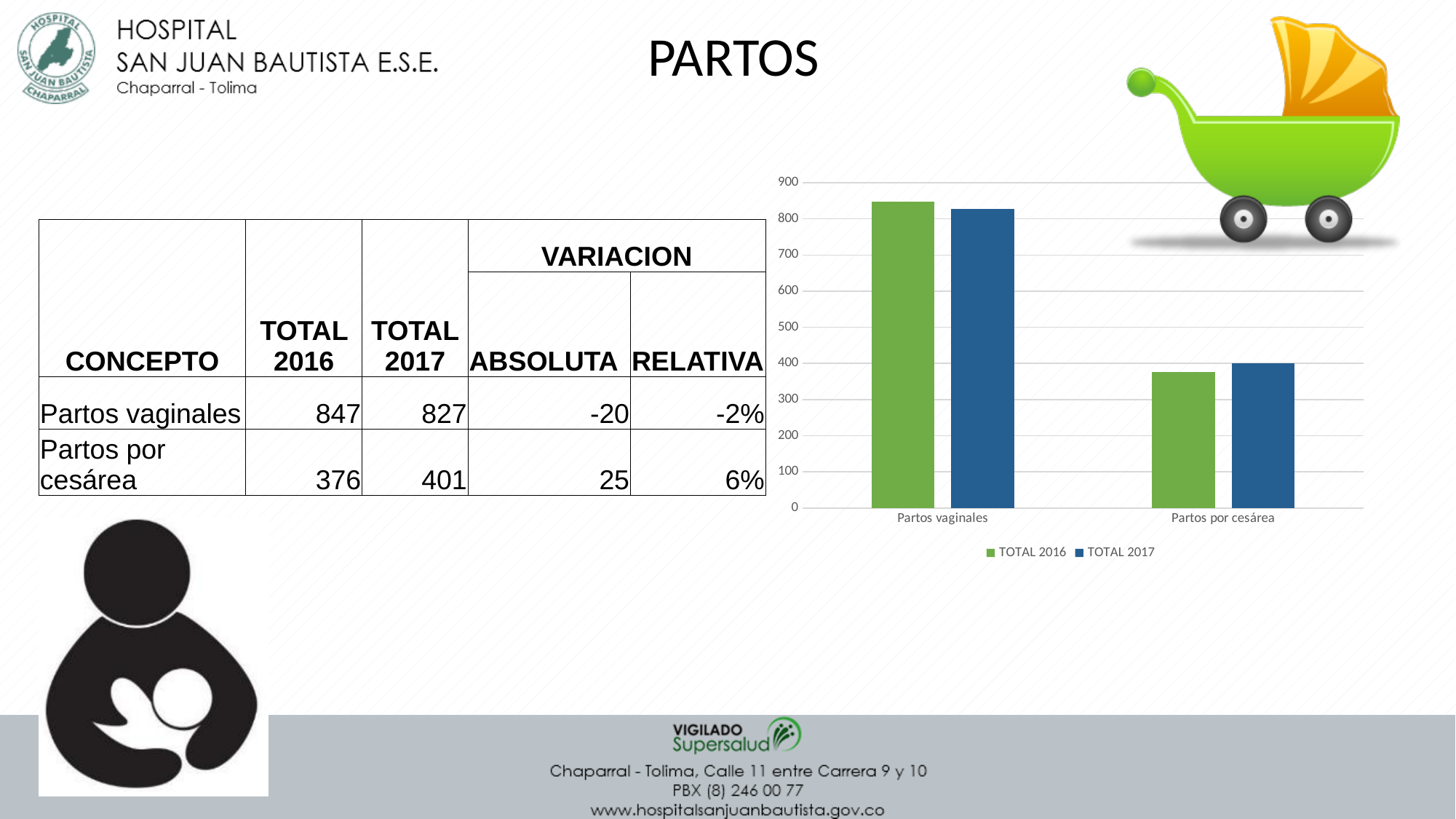
What is the TOTAL 2017 value for Partos vaginales, as printed in the table on the slide? 827 Is the TOTAL 2016 value for Partos por cesárea greater or less than 400? less For Partos vaginales, which is larger: TOTAL 2016 or TOTAL 2017? TOTAL 2016 Which category has the highest bar in the chart? Partos vaginales Which category has the lowest TOTAL 2016 value in the chart? Partos por cesárea Is the TOTAL 2017 value for Partos por cesárea greater or less than 500? less What kind of chart is shown on the slide? bar chart Which series does the green bar represent in the chart? TOTAL 2016 Is the TOTAL 2016 value for Partos vaginales greater or less than 800? greater How many series does the chart legend list? 2 What is the difference between the TOTAL 2017 and TOTAL 2016 values for Partos por cesárea, as printed in the table? 25 How many categories are shown on the x axis of the chart? 2